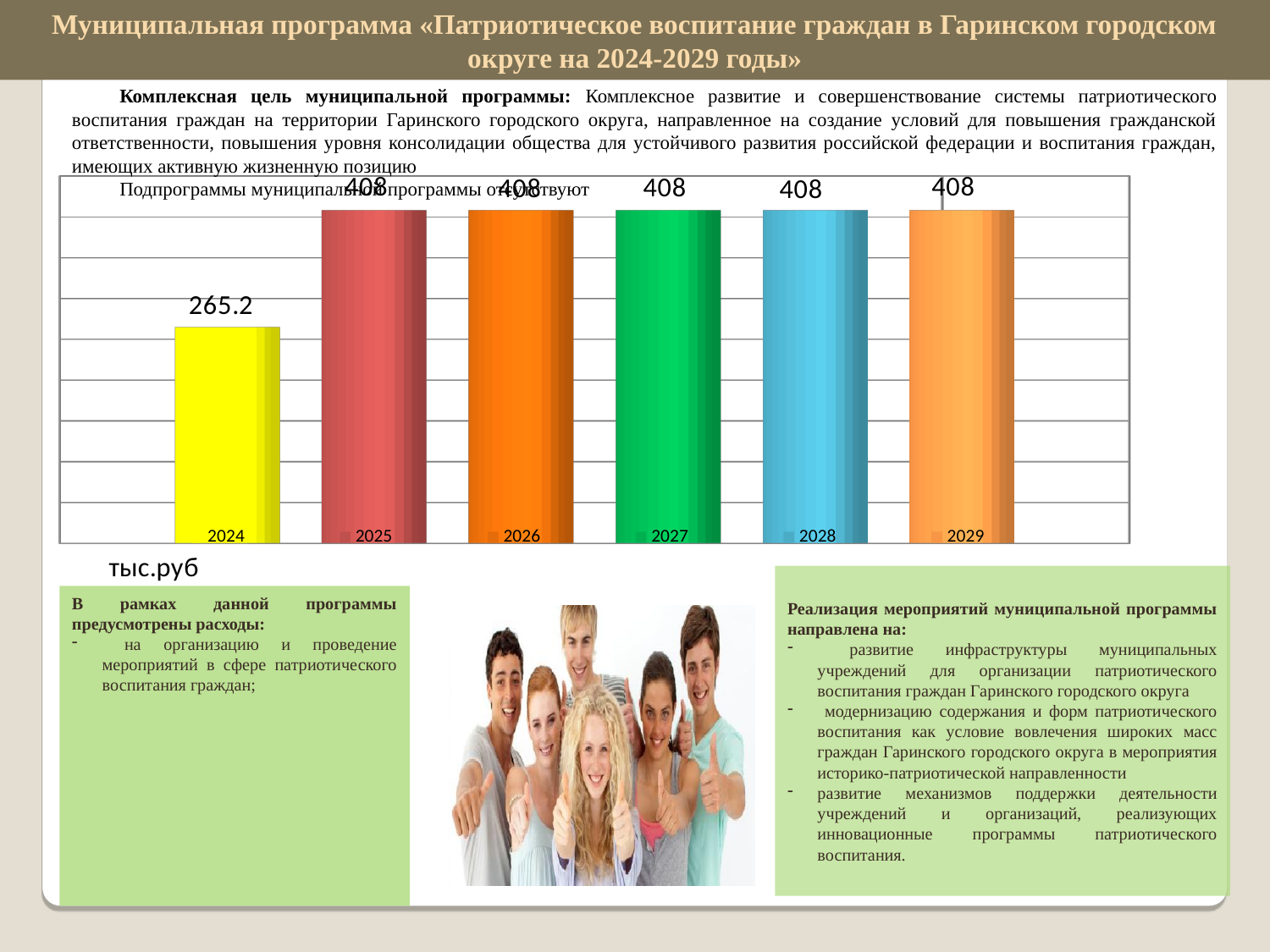
What unit is indicated below the chart? тыс.руб What is the value for 2027? 408 Which year has the lowest value? 2024 Do the values rise or fall from 2024 to 2025? rise What colour is the bar for 2024? yellow What kind of chart is shown? bar chart How many years are shown on the chart? 6 How many years have a value of 408? 5 What is the value for 2024? 265.2 What is the value for 2029? 408 Which is larger, the value for 2024 or the value for 2026? 2026 What is the difference between the values for 2025 and 2024? 142.8